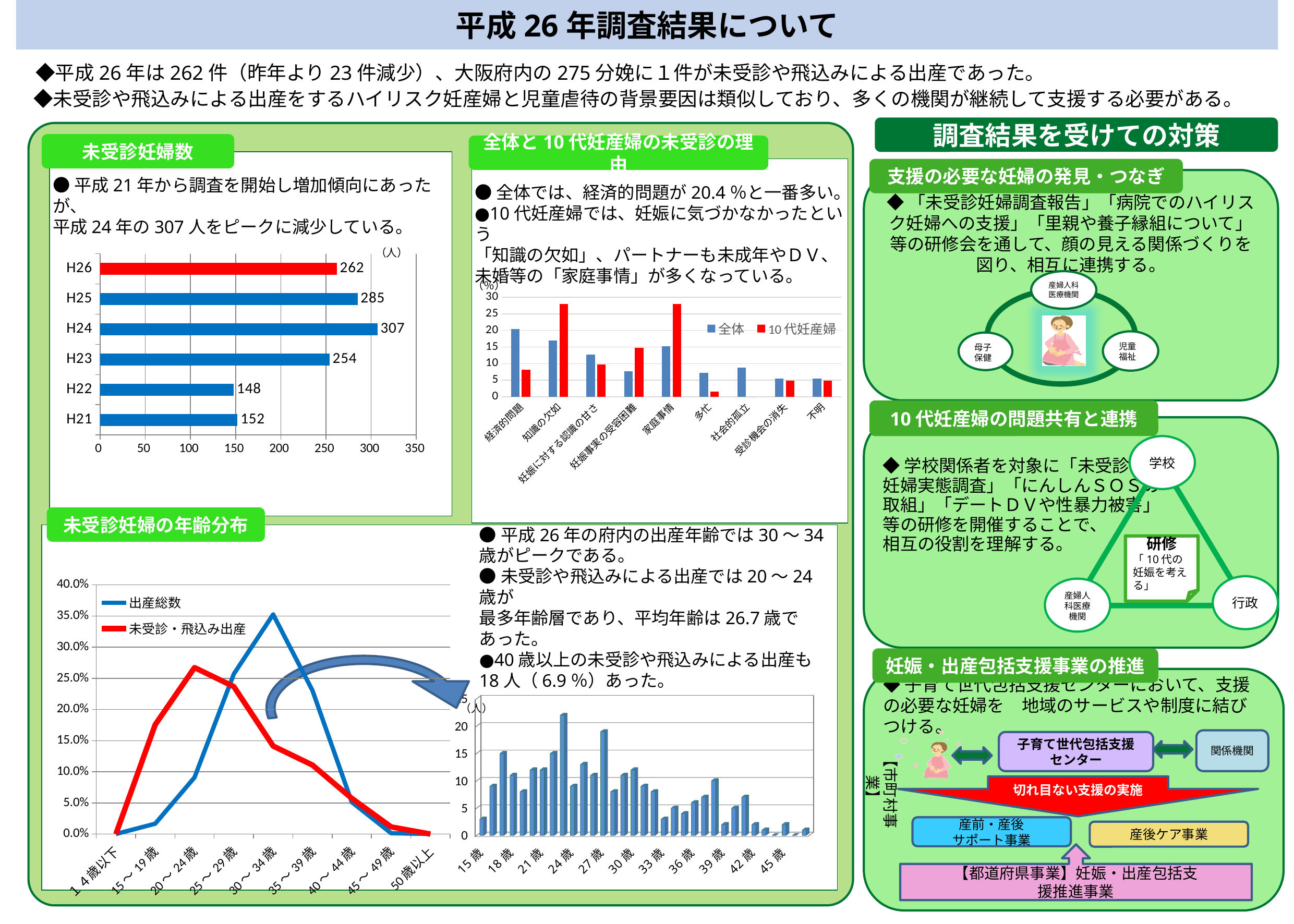
What kind of chart is the 未受診妊婦数 chart? bar chart In the 未受診妊婦数 chart, what is the difference between the values for H25 and H26? 23 In the 未受診妊婦数 chart, how many years are shown? 6 In the 未受診妊婦数 chart, which year has the highest value? H24 In the 未受診妊婦数 chart, what is the value for H21? 152 In the 全体と10代妊産婦の未受診の理由 chart, how many series does the legend list? 2 In the 未受診妊婦の年齢分布 line chart, which age group has the highest value for 未受診・飛込み出産? 20～24歳 In the 未受診妊婦数 chart, what is the value for H24? 307 In the 全体と10代妊産婦の未受診の理由 chart, is the 10代妊産婦 value for 知識の欠如 greater or less than 25? greater In the 未受診妊婦の年齢分布 line chart, which age group has the highest value for 出産総数? 30～34歳 In the 未受診妊婦数 chart, which is larger, the value for H23 or H26? H26 In the 未受診妊婦数 chart, which year has the lowest value? H22